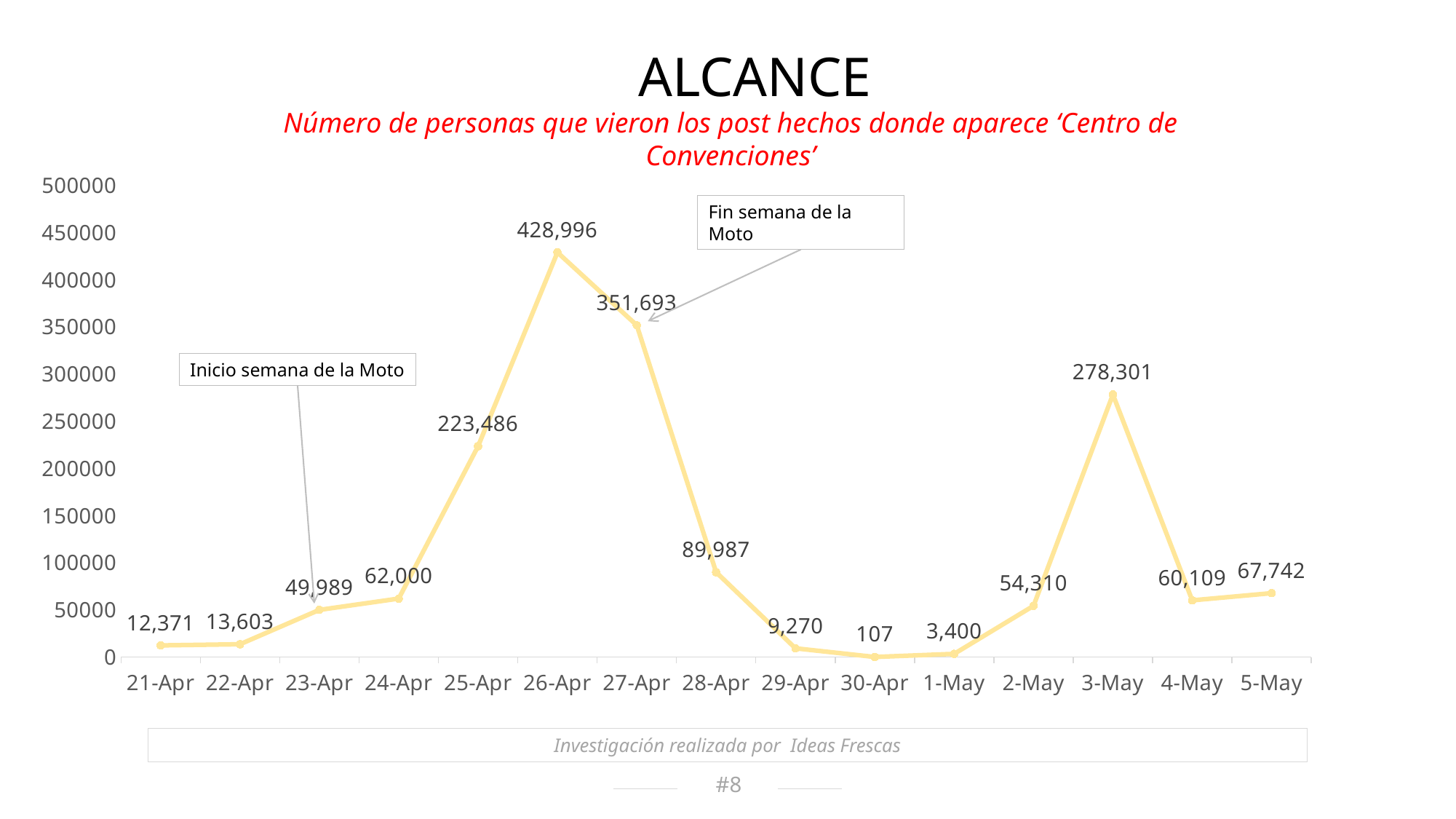
What is the difference between the values for 26-Apr and 27-Apr? 77,303 Which date has the lowest value? 30-Apr How many dates are plotted on the x axis? 15 Which is larger, the value for 28-Apr or the value for 2-May? 28-Apr What is the value for 30-Apr? 107 What is the difference between the values for 3-May and 25-Apr? 54,815 Which date has the highest value? 26-Apr What is the main title of the chart? ALCANCE What is the value for 26-Apr? 428,996 What is the value for 3-May? 278,301 What type of chart is shown on the slide? line chart Do the values rise or fall from 26-Apr to 30-Apr? fall